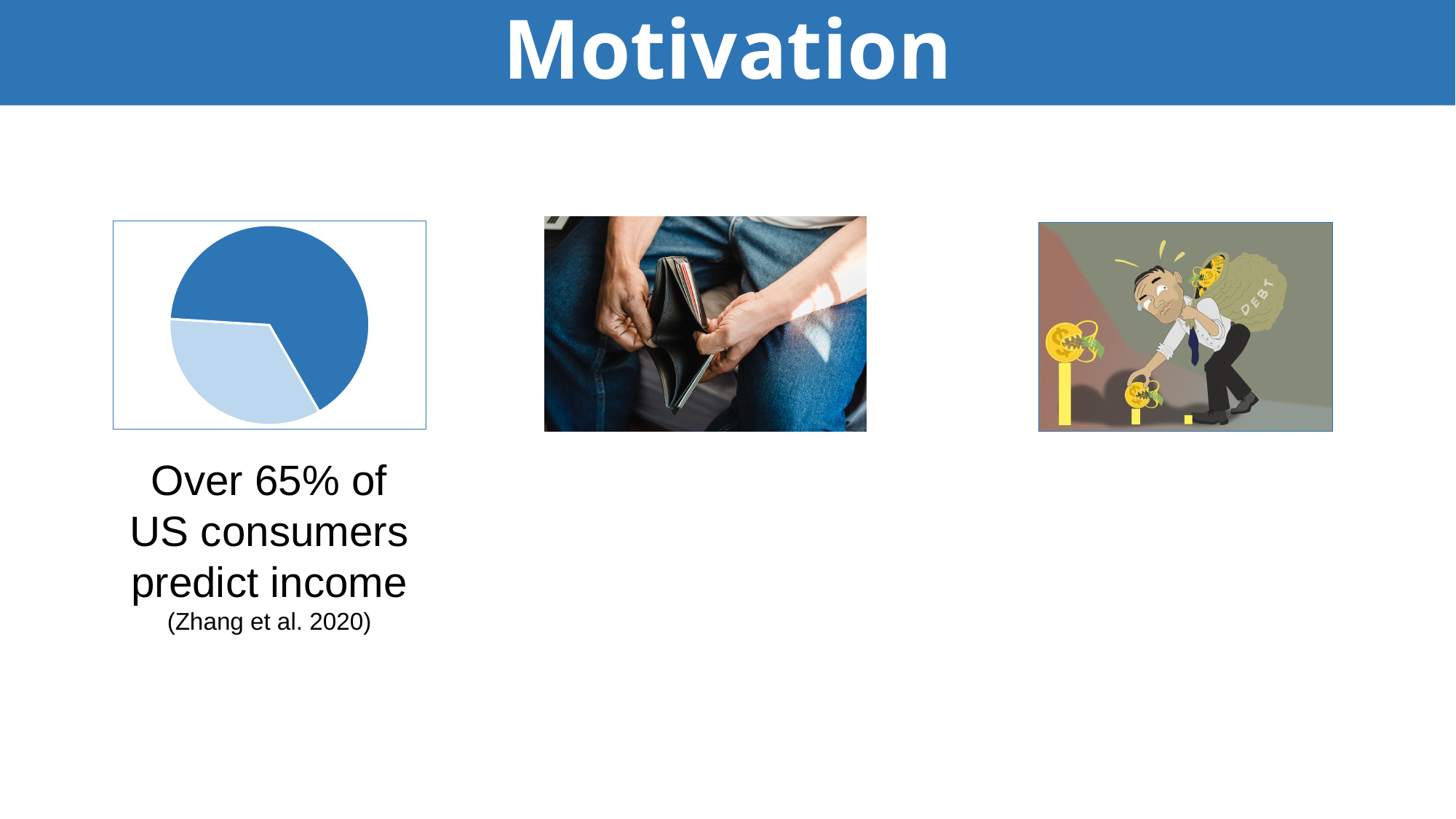
Which slice of the pie chart is the smallest? light blue slice How many slices does the pie chart have? 2 Which slice of the pie chart is the largest? dark blue slice Does the pie chart display a legend? No What kind of chart is shown on the left of the slide? pie chart What percentage of US consumers does the caption under the pie chart say predict income? Over 65% Which slice of the pie chart is larger, the dark blue slice or the light blue slice? dark blue slice